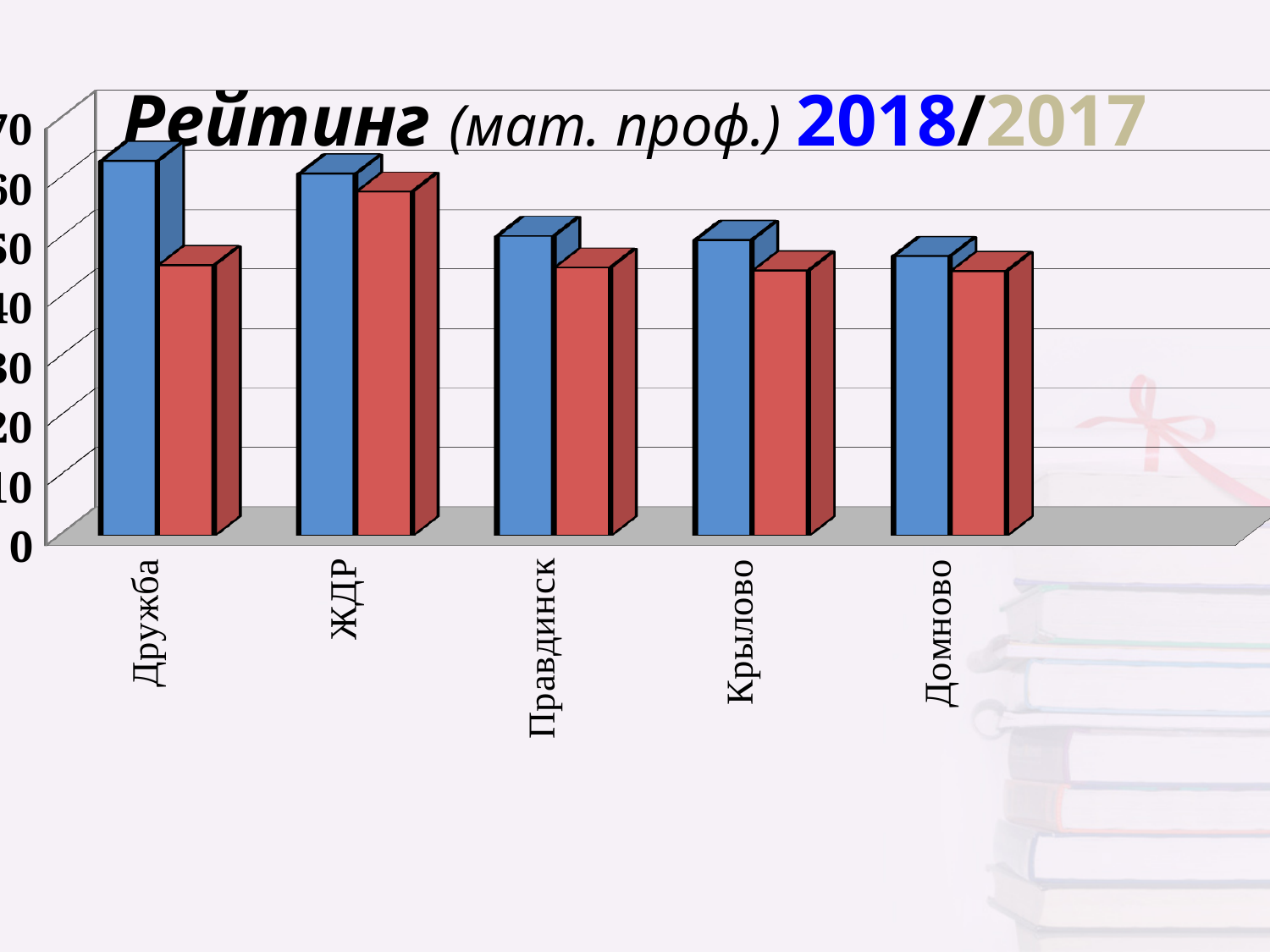
Is the red bar for ЖДР greater or less than 50? greater Is the blue bar for Дружба greater or less than 60? greater How many categories (schools) are shown on the x axis of the chart? 5 For Дружба, which bar is taller, the blue one or the red one? the blue one What kind of chart is shown on the slide? bar chart Is the blue bar for Домново greater or less than 50? less Do the blue bars rise or fall from left to right across the categories? fall Which category has the tallest red bar? ЖДР Which category has the tallest blue bar? Дружба What is the title of the chart? Рейтинг (мат. проф.) 2018/2017